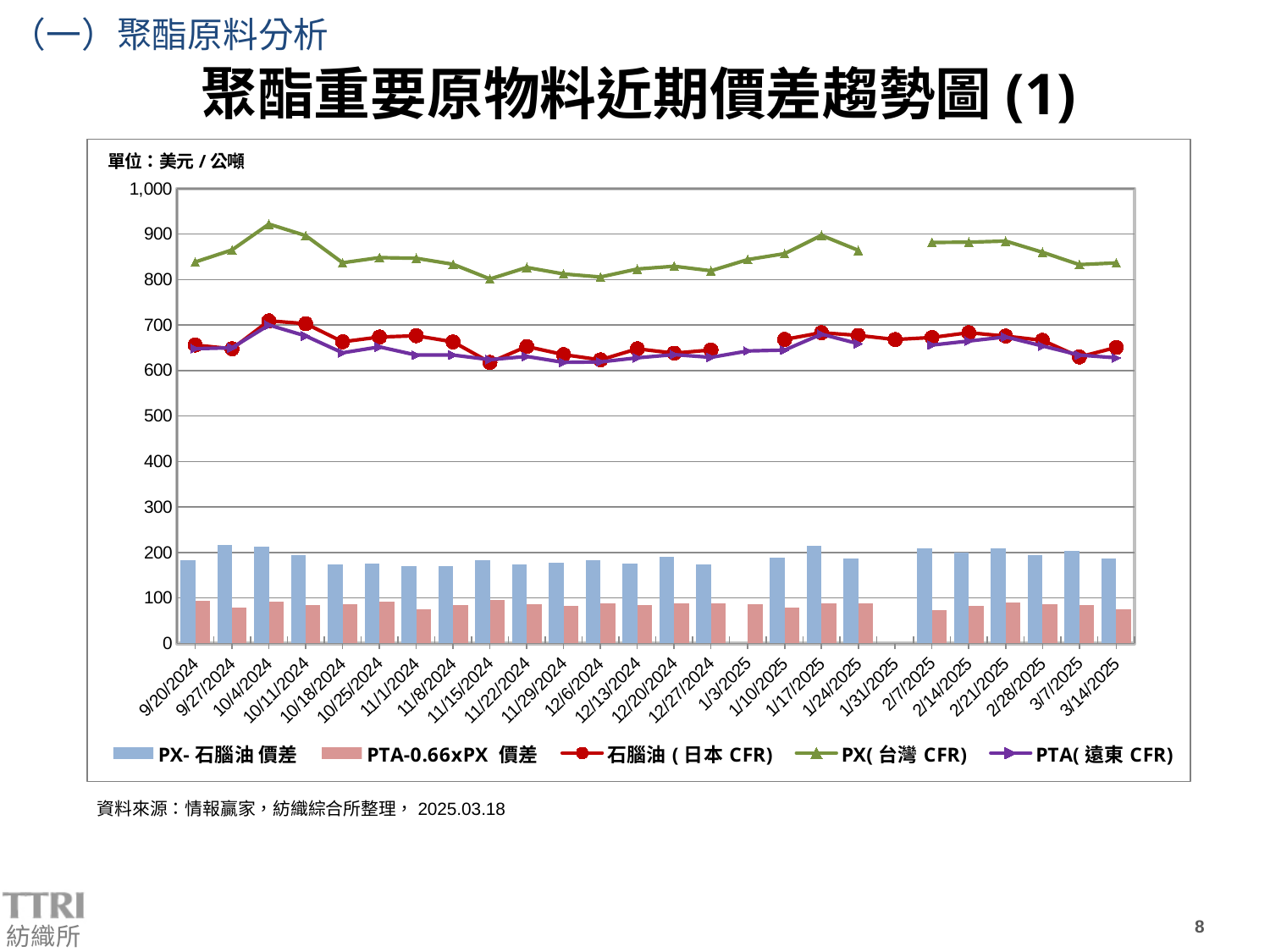
On which date does the PX( 台灣 CFR) line reach its highest value? 10/4/2024 Is the PTA-0.66xPX 價差 bar on 9/27/2024 greater or less than 100? less On 12/6/2024, which line is higher: PX( 台灣 CFR) or 石腦油 ( 日本 CFR)? PX( 台灣 CFR) Is the PX- 石腦油 價差 bar on 9/27/2024 greater or less than 200? greater What kind of chart is shown on the slide? A combined bar and line chart How many dates are shown on the x axis? 26 Is the value of PX( 台灣 CFR) on 10/4/2024 greater or less than 900? greater Does the PX( 台灣 CFR) line rise or fall from 9/20/2024 to 10/4/2024? rise What unit is stated for the values in the chart? 美元 / 公噸 How many series does the legend list? 5 On 9/20/2024, which is larger: the PX- 石腦油 價差 bar or the PTA-0.66xPX 價差 bar? PX- 石腦油 價差